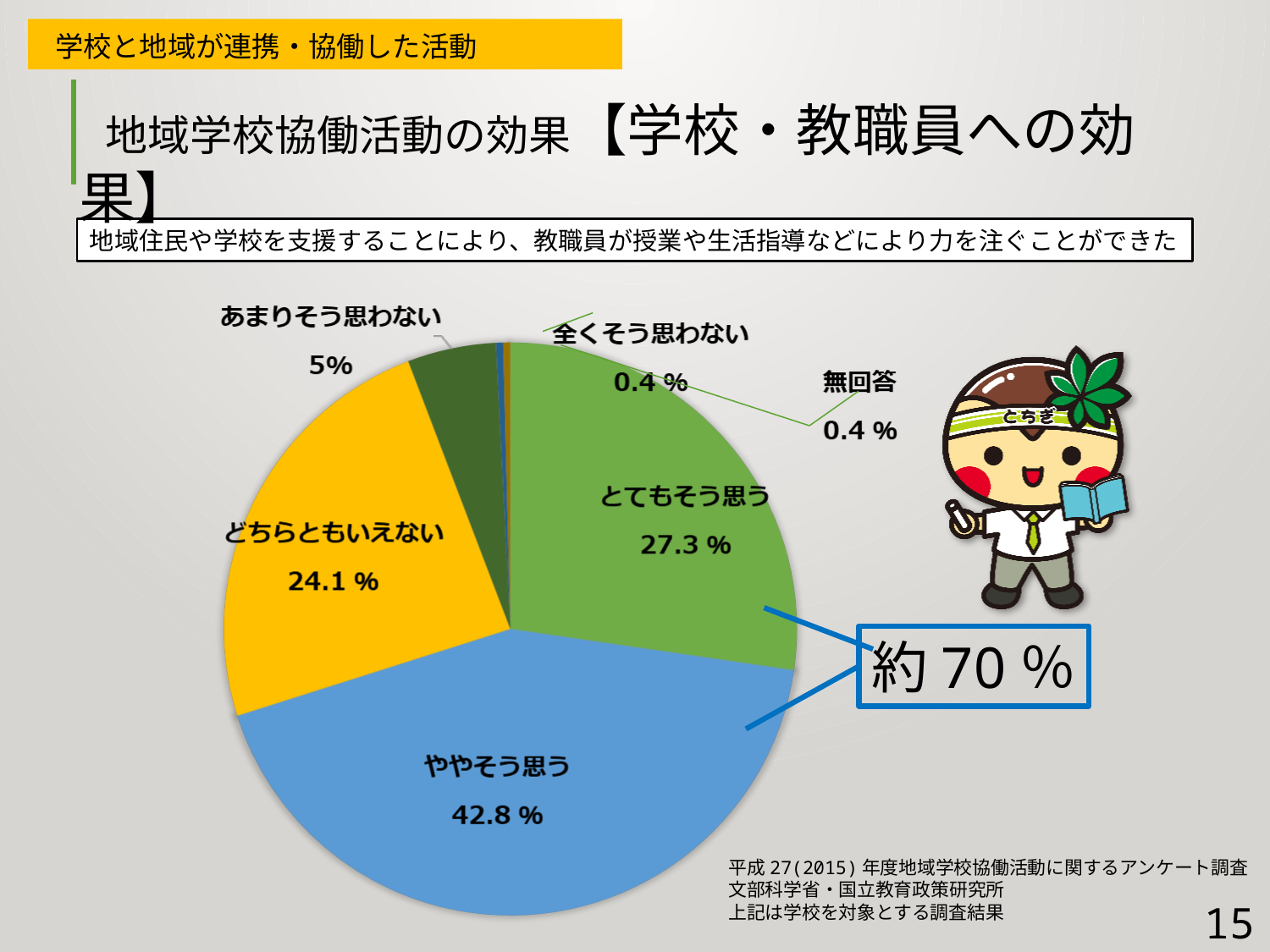
What percentage is shown for あまりそう思わない? 5% What is the difference in percentage points between ややそう思う and とてもそう思う? 15.5 What is the difference in percentage points between どちらともいえない and あまりそう思わない? 19.1 What kind of chart is shown on the slide? Pie chart What percentage is shown for ややそう思う? 42.8 % Which is larger, the share for とてもそう思う or the share for どちらともいえない? とてもそう思う Which response category has the largest share of the pie? ややそう思う What percentage is shown for どちらともいえない? 24.1 % How many slices does the pie chart have? 6 What approximate combined percentage is highlighted in the blue box next to the pie chart? 約70％ What percentage is shown for 全くそう思わない? 0.4 % What percentage is shown for とてもそう思う? 27.3 %